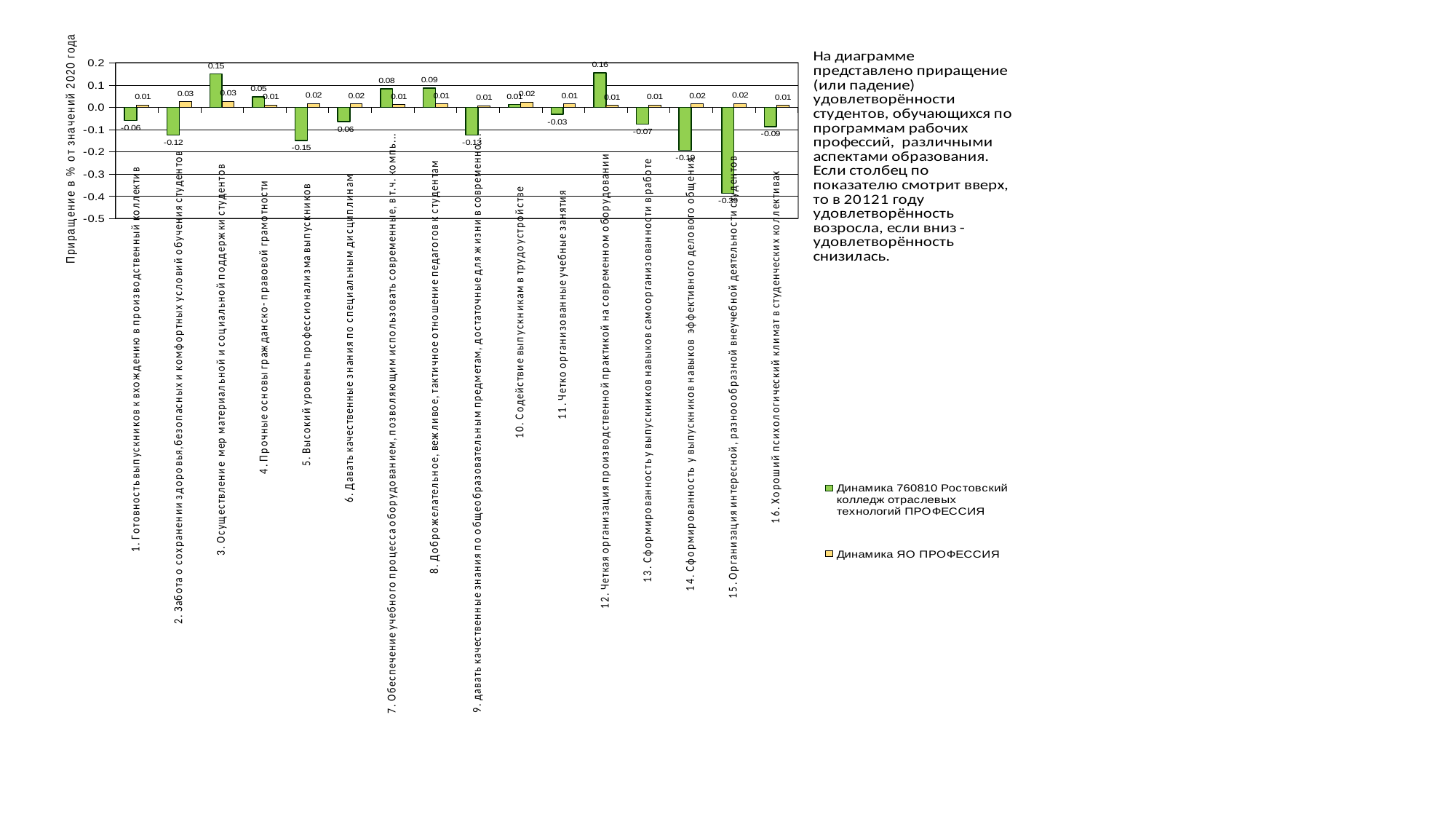
For which indicator is the green series (Ростовский колледж) lowest? 15. Организация интересной, разнообразной внеучебной деятельности студентов For which indicator is the green series (Ростовский колледж) highest? 12. Четкая организация производственной практикой на современном оборудовании What is the value of the green series (Динамика 760810 Ростовский колледж) for indicator 3 (Осуществление мер материальной и социальной поддержки студентов)? 0.15 What is the title of the vertical axis? Приращение в % от значений 2020 года For indicator 3, what is the difference between the green series value and the yellow series value? 0.12 What is the value of the green series for indicator 5 (Высокий уровень профессионализма выпускников)? -0.15 What is the value of the green series for indicator 16 (Хороший психологический климат в студенческих коллективах)? -0.09 What kind of chart is shown on the slide? Bar chart How many categories (indicators) are plotted along the x axis? 16 Is the green series value for indicator 15 greater or less than -0.3? less What is the value of the yellow series (Динамика ЯО ПРОФЕССИЯ) for indicator 2 (Забота о сохранении здоровья)? 0.03 How many series does the legend list? 2